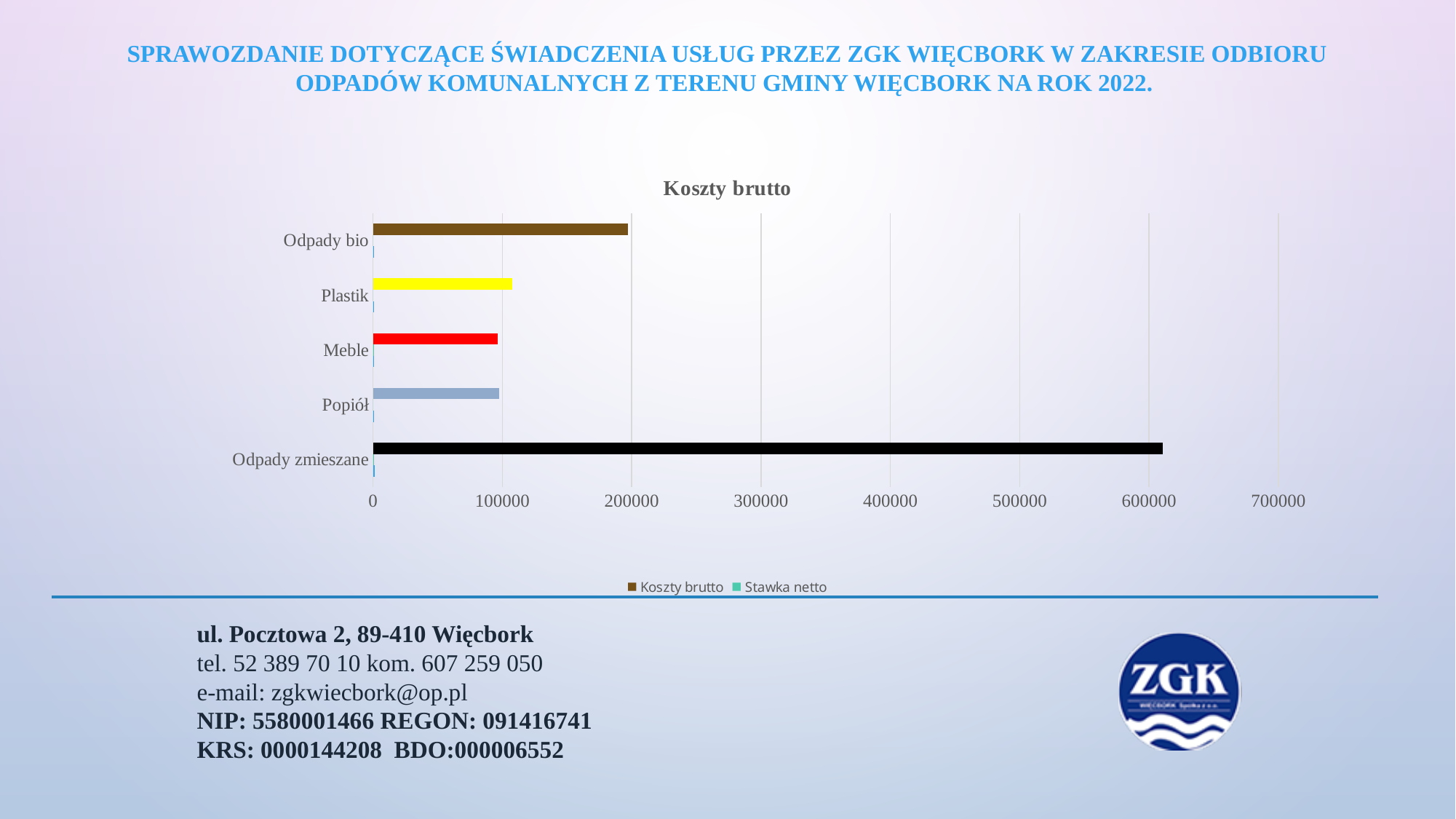
Which has a larger Koszty brutto value, Odpady zmieszane or Odpady bio? Odpady zmieszane How many categories are shown on the chart? 5 Which category has the highest Koszty brutto value? Odpady zmieszane What are the two series names listed in the legend? Koszty brutto and Stawka netto Is the Koszty brutto value for Odpady zmieszane greater or less than 500000? greater What kind of chart is shown on the slide? bar chart Is the Koszty brutto value for Odpady bio greater or less than 100000? greater What is the title of the chart? Koszty brutto Is the Koszty brutto value for Meble greater or less than 200000? less Which has a larger Koszty brutto value, Odpady bio or Plastik? Odpady bio How many series does the legend list? 2